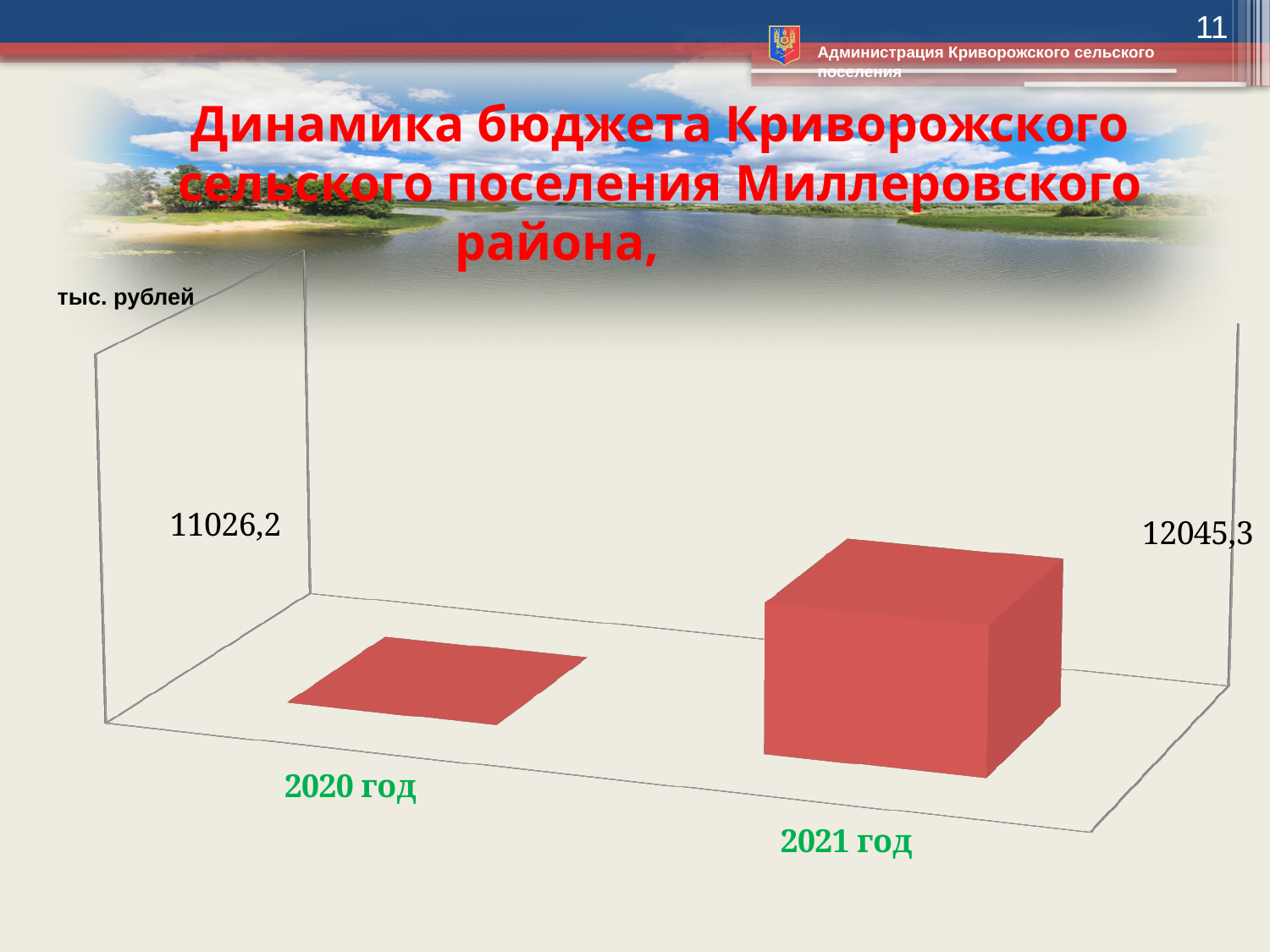
Is the value for 2021 год larger or smaller than the value for 2020 год? larger Which year has the higher budget value? 2021 год How many years (categories) are shown in the chart? 2 Does the budget value rise or fall from 2020 год to 2021 год? rise What kind of chart is shown on the slide? bar chart By how much does the 2021 год value exceed the 2020 год value? 1019,1 In what units are the chart values given? тыс. рублей What colour are the bars in the chart? red Which year has the lower budget value? 2020 год What is the budget value shown for 2021 год? 12045,3 What is the budget value shown for 2020 год? 11026,2